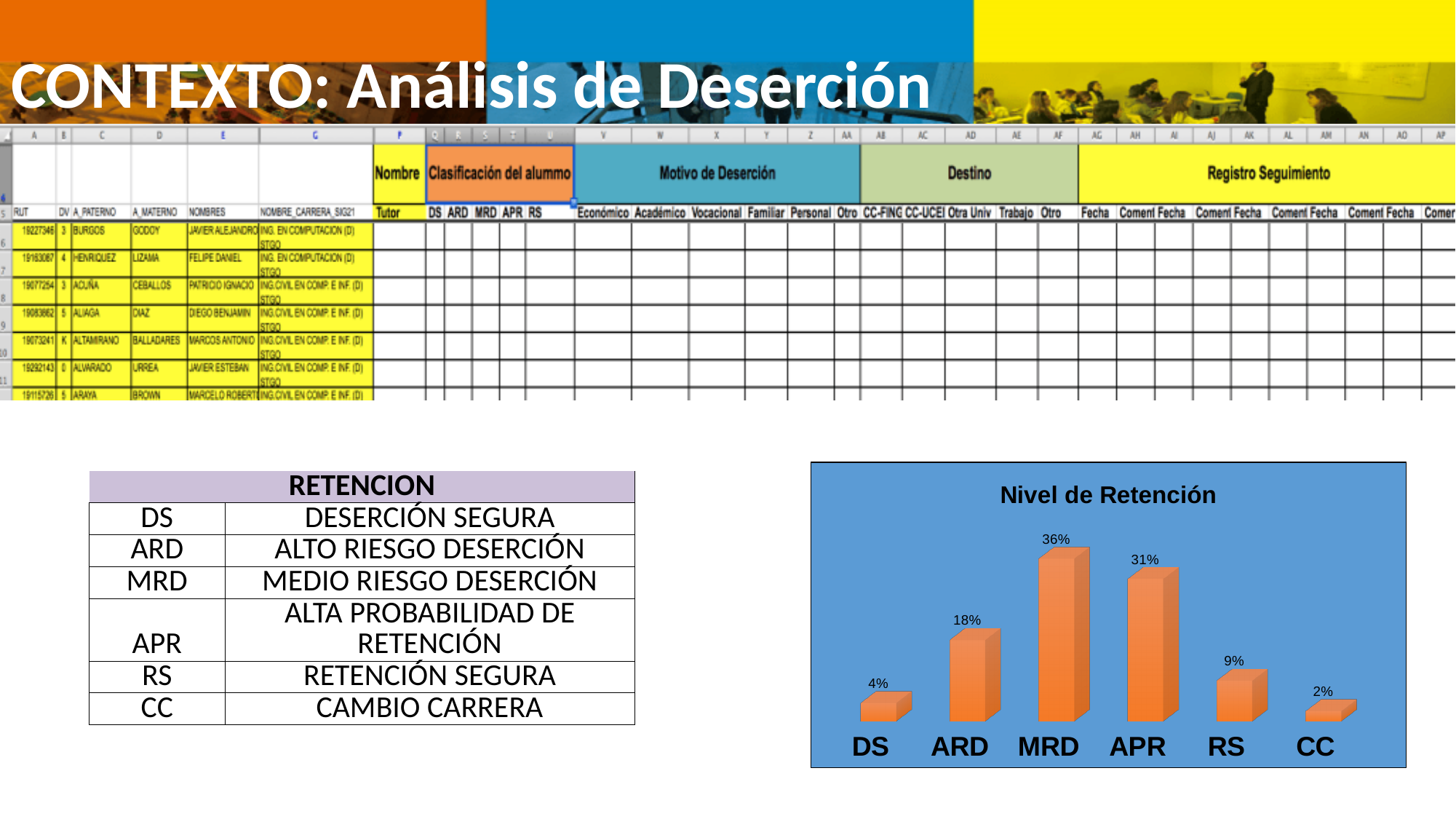
Which category has the lowest value in the Nivel de Retención chart? CC Which category has the highest value in the Nivel de Retención chart? MRD What is the value for MRD in the Nivel de Retención chart? 36% What is the title of the chart on the slide? Nivel de Retención What is the value for RS in the Nivel de Retención chart? 9% Which is larger in the Nivel de Retención chart, the value for ARD or the value for RS? ARD What is the difference between the values for MRD and APR in the Nivel de Retención chart? 5% How many categories are shown in the Nivel de Retención chart? 6 What kind of chart is the Nivel de Retención chart? Bar chart What is the difference between the values for ARD and RS in the Nivel de Retención chart? 9% What is the value for ARD in the Nivel de Retención chart? 18% What is the value for DS in the Nivel de Retención chart? 4%